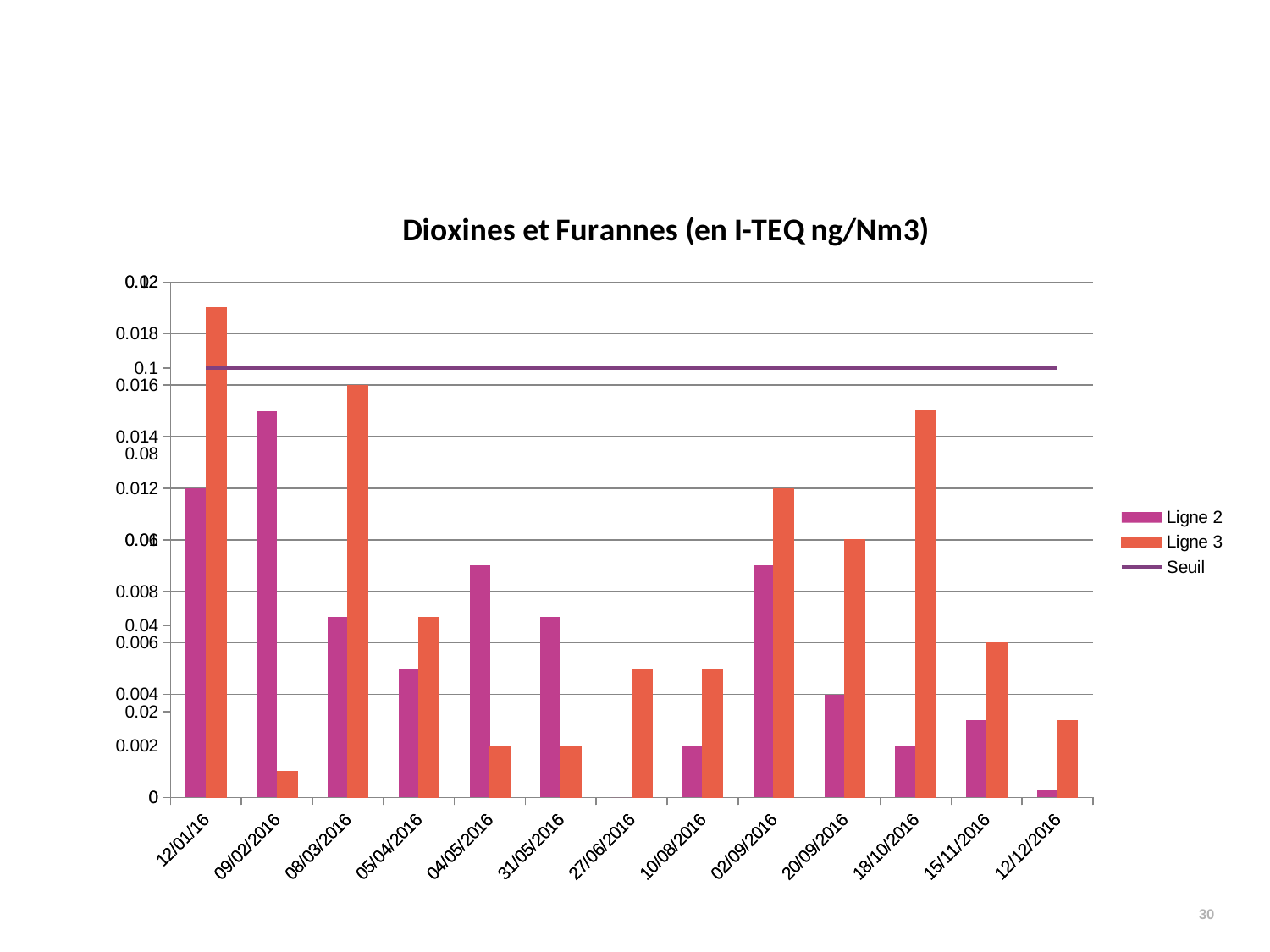
On 12/01/16, which is larger, Ligne 2 or Ligne 3? Ligne 3 Which legend entry is drawn as a line rather than bars? Seuil On which date is the Ligne 3 bar the tallest? 12/01/16 On 09/02/2016, which is larger, Ligne 2 or Ligne 3? Ligne 2 Among the dates where a Ligne 3 bar is drawn, on which date is it the shortest? 09/02/2016 How many dates are shown on the x axis? 13 What is the title of the chart? Dioxines et Furannes (en I-TEQ ng/Nm3) What kind of chart is shown on the slide? Combination bar and line chart On which date is the Ligne 2 bar the tallest? 09/02/2016 On 18/10/2016, which is larger, Ligne 2 or Ligne 3? Ligne 3 Do the Ligne 3 bars rise or fall from 08/03/2016 to 04/05/2016? Fall How many entries does the legend list? 3